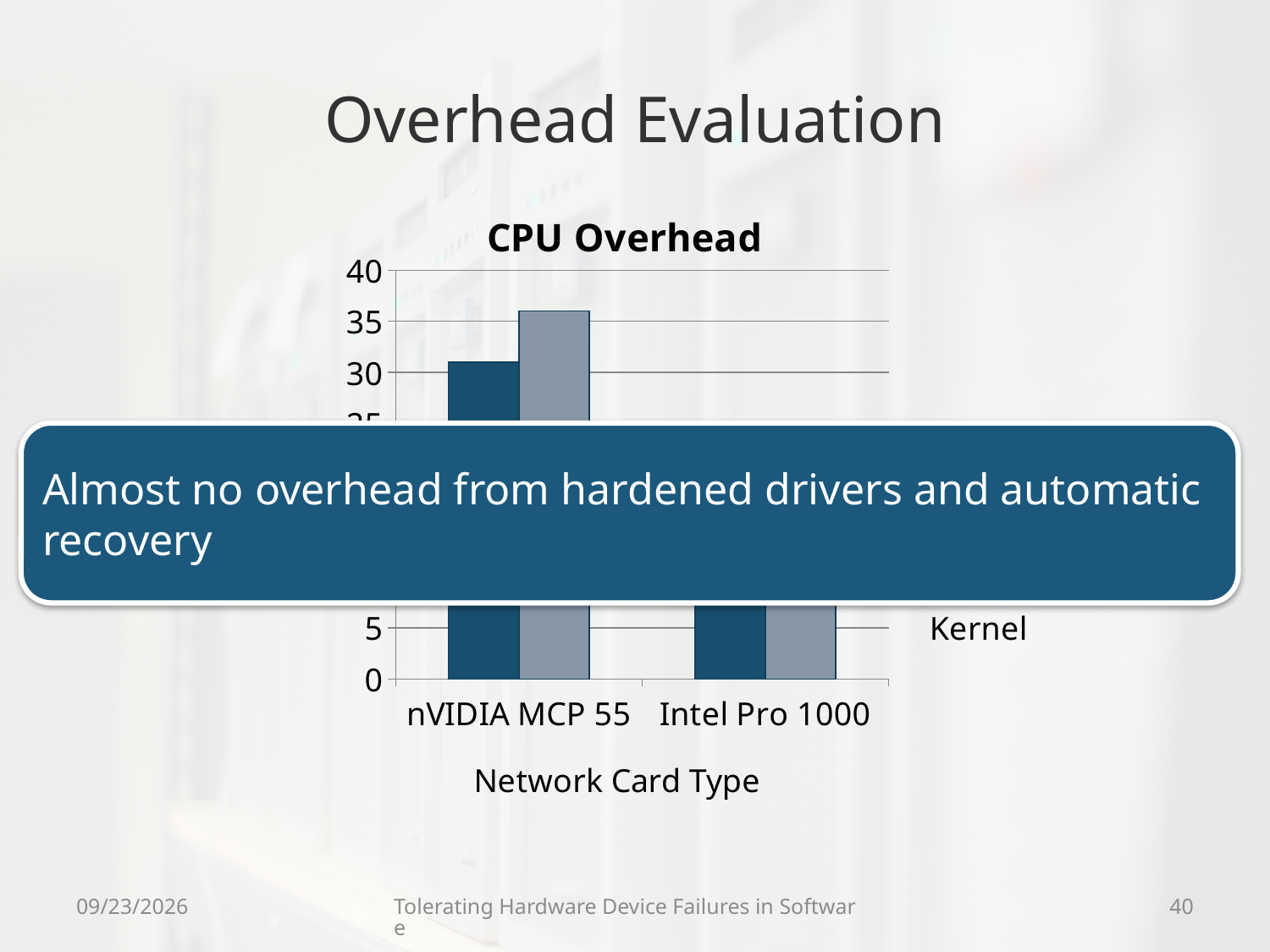
In the CPU Overhead chart, which network card type has the shorter bars? Intel Pro 1000 In the CPU Overhead chart, is the light grey bar for nVIDIA MCP 55 greater or less than 35? greater What is the x-axis title of the CPU Overhead chart? Network Card Type What is the title of the chart on the slide? CPU Overhead In the CPU Overhead chart, which network card type has the taller bars? nVIDIA MCP 55 What kind of chart is the CPU Overhead chart? bar chart In the CPU Overhead chart, for nVIDIA MCP 55, which bar is taller: the dark blue bar or the light grey bar? the light grey bar In the CPU Overhead chart, is the light grey bar for nVIDIA MCP 55 greater or less than 40? less How many network card types are shown on the x axis of the CPU Overhead chart? 2 In the CPU Overhead chart, is the dark blue bar for nVIDIA MCP 55 greater or less than 35? less Do the bar heights in the CPU Overhead chart rise or fall from nVIDIA MCP 55 to Intel Pro 1000? fall In the CPU Overhead chart, is the dark blue bar for nVIDIA MCP 55 taller or shorter than the dark blue bar for Intel Pro 1000? taller